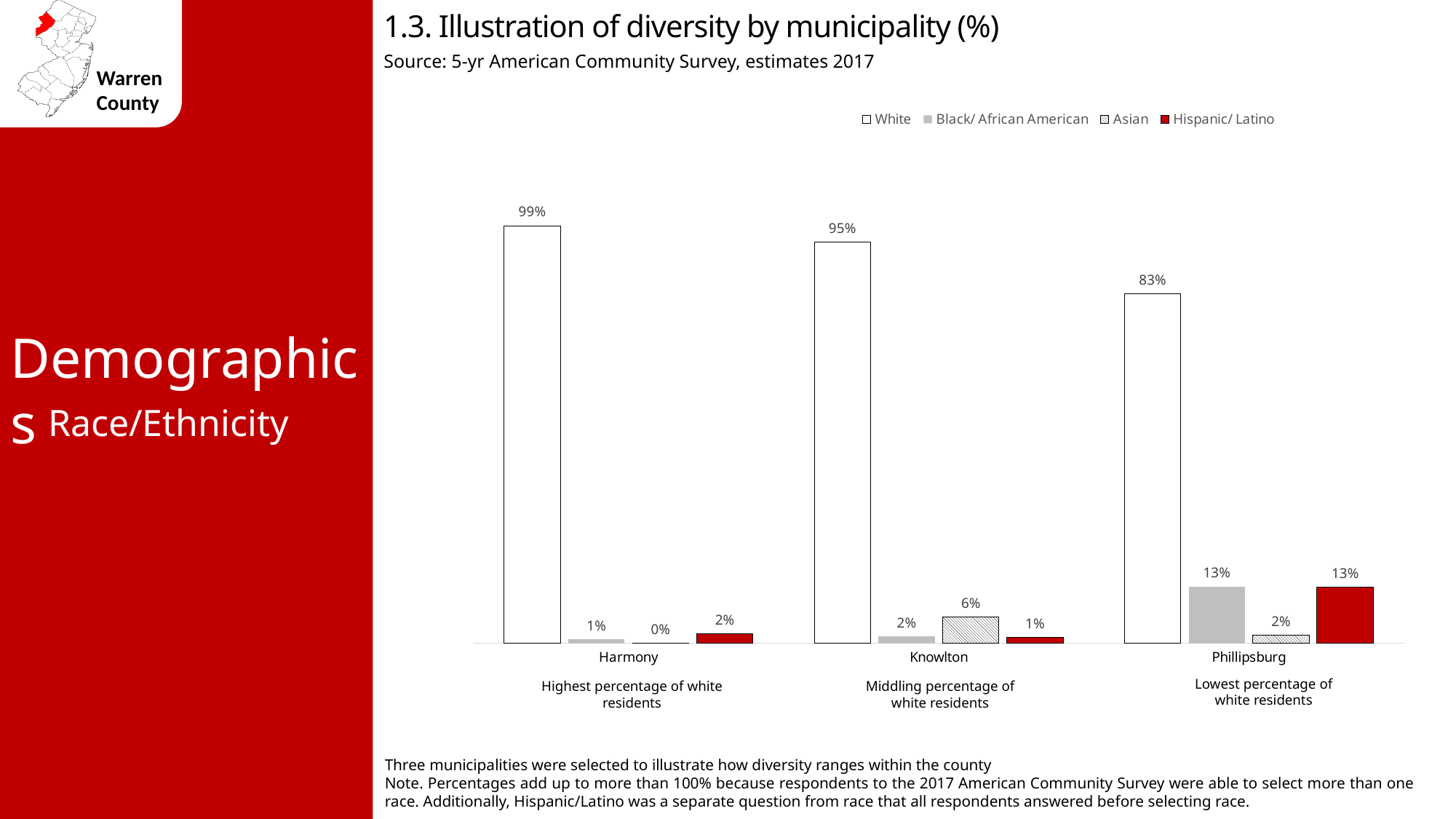
What is the Black/ African American percentage for Harmony? 1% Which municipality has the lowest White percentage? Phillipsburg What is the White percentage for Harmony? 99% How many municipalities are shown on the chart? 3 Which series is shown in red on the chart? Hispanic/ Latino Which municipality has the highest Hispanic/ Latino percentage? Phillipsburg How many series does the legend list? 4 What is the Hispanic/ Latino percentage for Phillipsburg? 13% Which is larger, the Asian percentage for Knowlton or the Asian percentage for Phillipsburg? Knowlton What is the difference between the White percentage for Harmony and for Phillipsburg? 16% What is the Asian percentage for Knowlton? 6% What kind of chart is shown on the slide? Bar chart